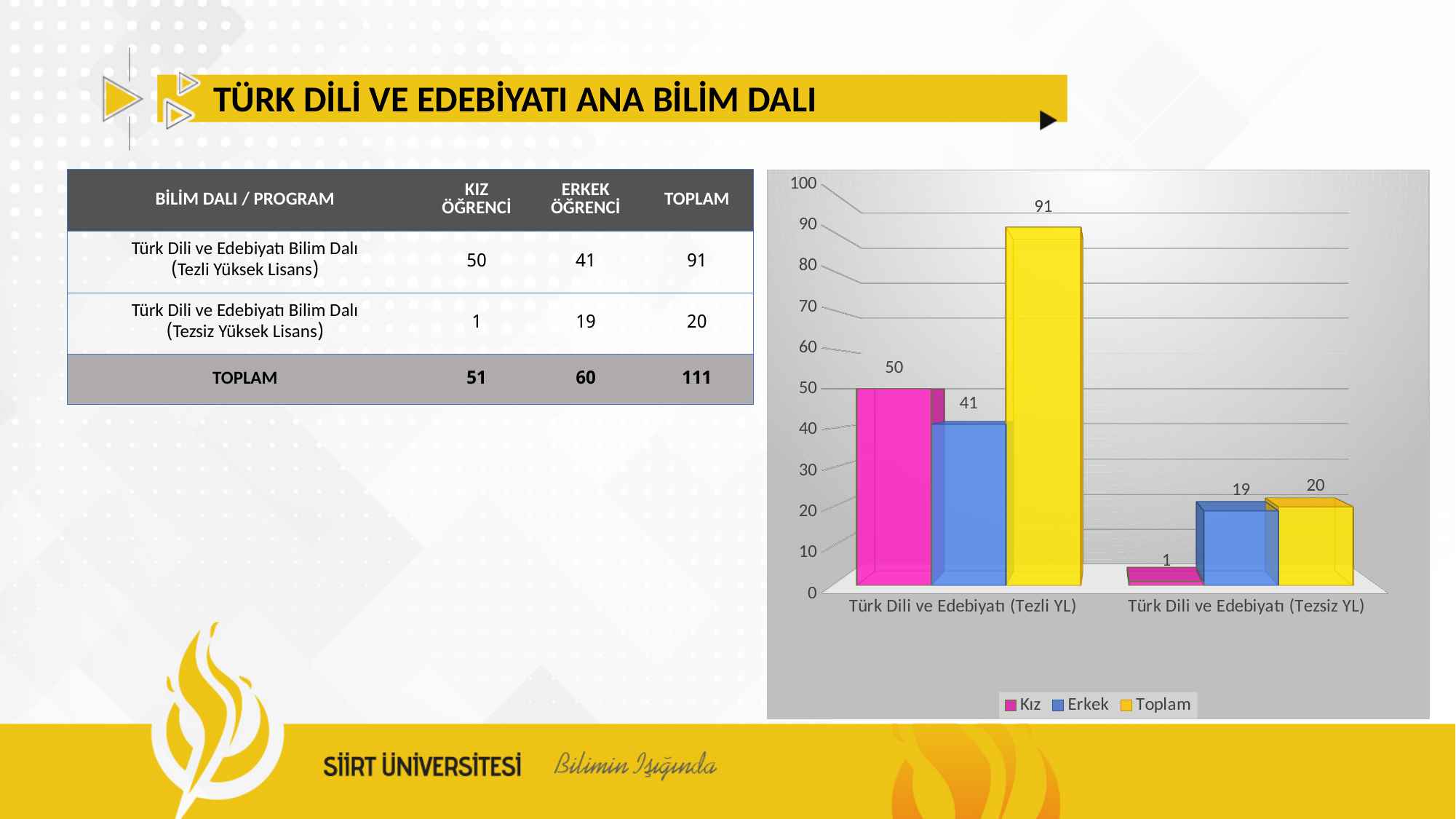
Which series has the lowest value for Türk Dili ve Edebiyatı (Tezsiz YL)? Kız What is the value of Kız for Türk Dili ve Edebiyatı (Tezli YL)? 50 What is the difference between the Kız and Erkek values for Türk Dili ve Edebiyatı (Tezli YL)? 9 Which is larger: Erkek for Türk Dili ve Edebiyatı (Tezli YL) or Erkek for Türk Dili ve Edebiyatı (Tezsiz YL)? Türk Dili ve Edebiyatı (Tezli YL) Which category has the highest Toplam value? Türk Dili ve Edebiyatı (Tezli YL) How many categories are shown on the x axis of the chart? 2 What is the difference between the Toplam values of the two categories? 71 How many series does the chart legend list? 3 What is the value of Toplam for Türk Dili ve Edebiyatı (Tezli YL)? 91 What kind of chart is shown on the slide? Bar chart What is the value of Erkek for Türk Dili ve Edebiyatı (Tezsiz YL)? 19 What is the value of Kız for Türk Dili ve Edebiyatı (Tezsiz YL)? 1